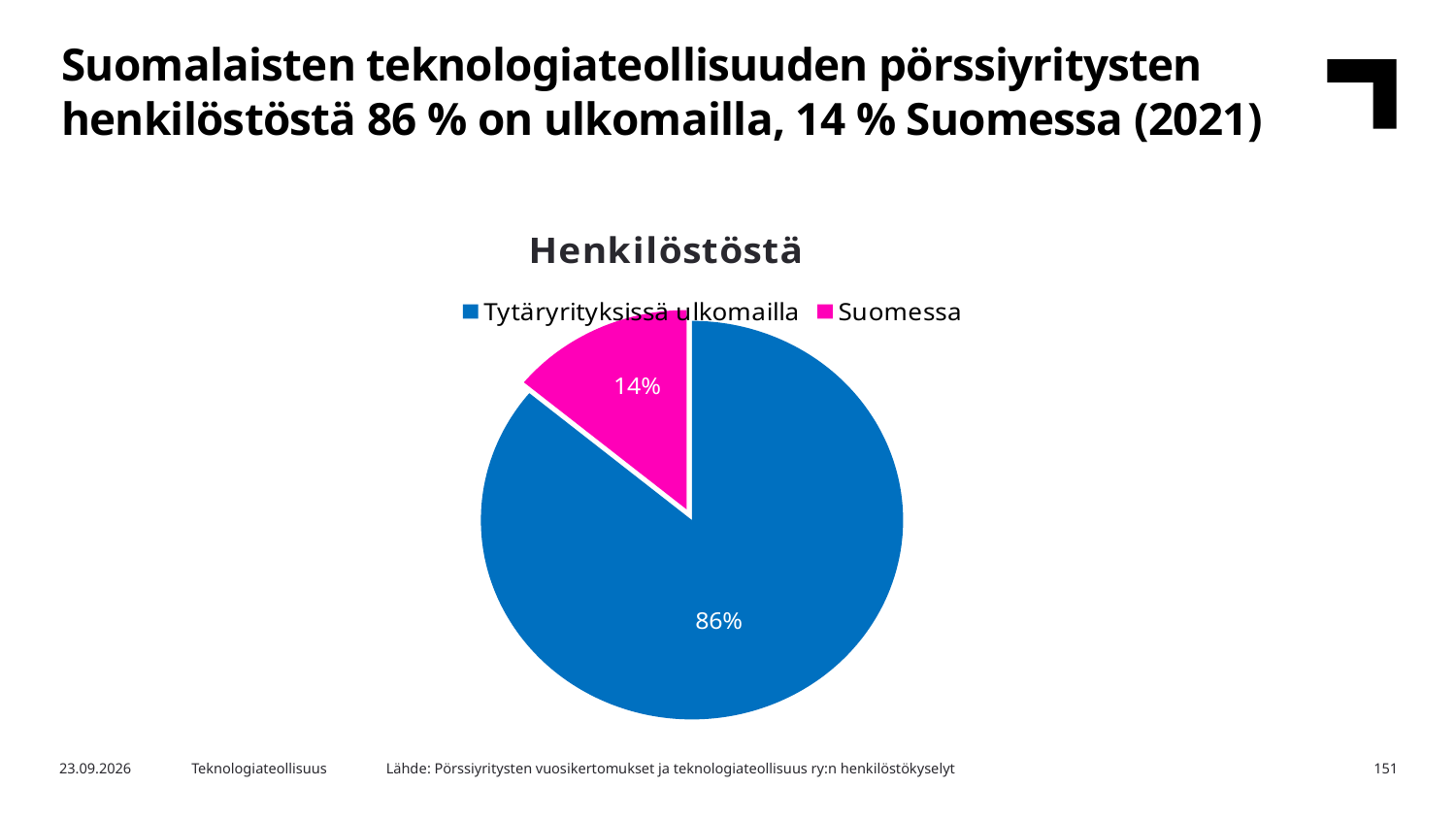
How many entries does the legend list? 2 What share of the pie does the Suomessa slice represent? 14% Which slice of the pie is the largest? Tytäryrityksissä ulkomailla Which is larger, the Suomessa slice or the Tytäryrityksissä ulkomailla slice? Tytäryrityksissä ulkomailla How many slices does the pie chart have? 2 What share of the pie does the Tytäryrityksissä ulkomailla slice represent? 86% What is the title of the chart? Henkilöstöstä What colour is the Suomessa slice in the pie chart? Pink (magenta) What is the difference in percentage points between the Tytäryrityksissä ulkomailla slice and the Suomessa slice? 72 percentage points What kind of chart is shown on the slide? Pie chart Which slice of the pie is the smallest? Suomessa